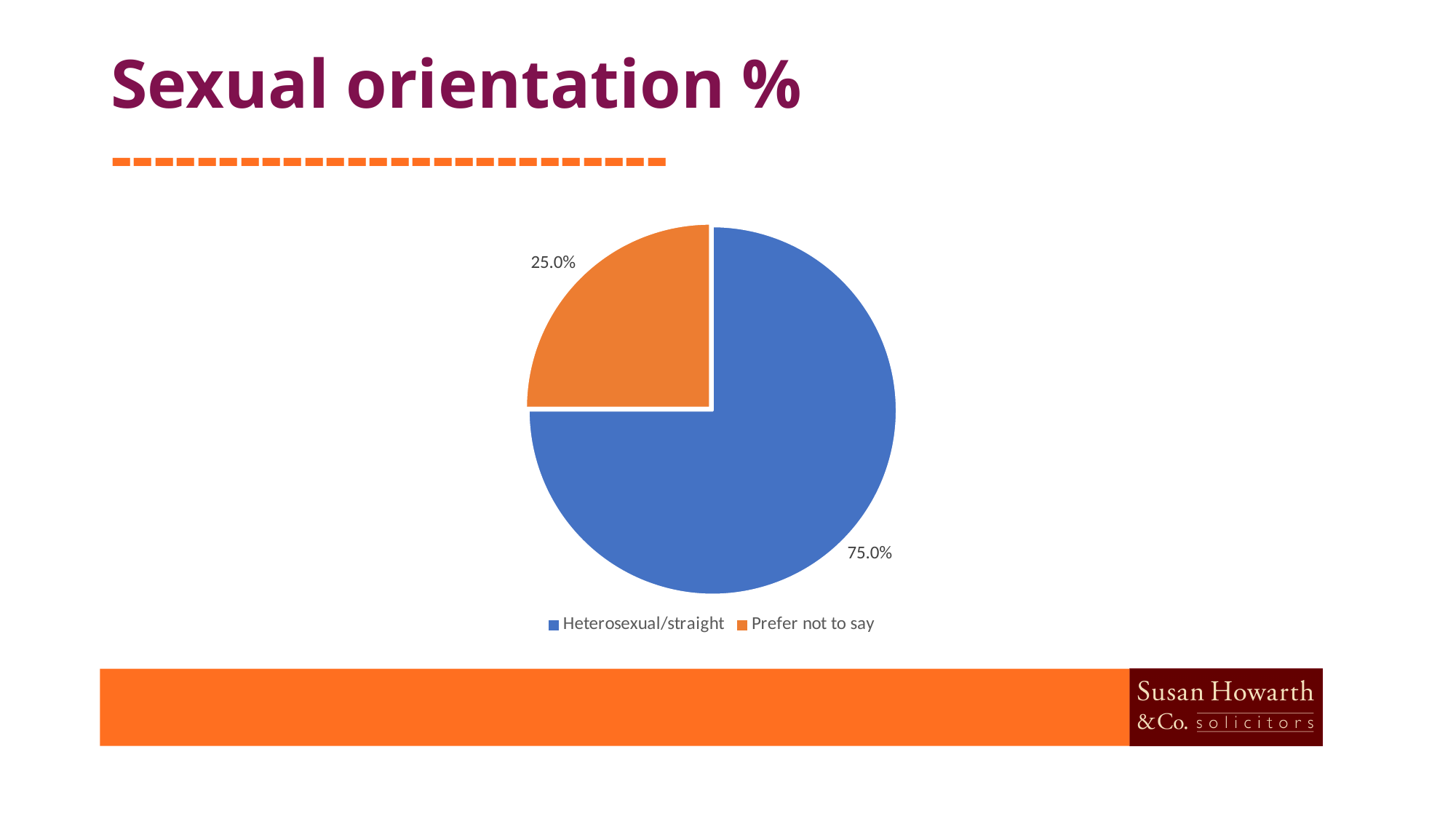
What percentage of the pie is Heterosexual/straight? 75.0% What is the title of the slide containing the chart? Sexual orientation % What percentage of the pie is Prefer not to say? 25.0% Which is larger, the share for Heterosexual/straight or the share for Prefer not to say? Heterosexual/straight How many entries does the legend list? 2 What colour is the Prefer not to say slice? Orange How many slices does the pie chart have? 2 What is the difference in percentage points between Heterosexual/straight and Prefer not to say? 50.0% Which category has the smallest share of the pie? Prefer not to say What kind of chart is shown on the slide? Pie chart Which category has the largest share of the pie? Heterosexual/straight What share of the pie does the Prefer not to say slice represent? 25.0%